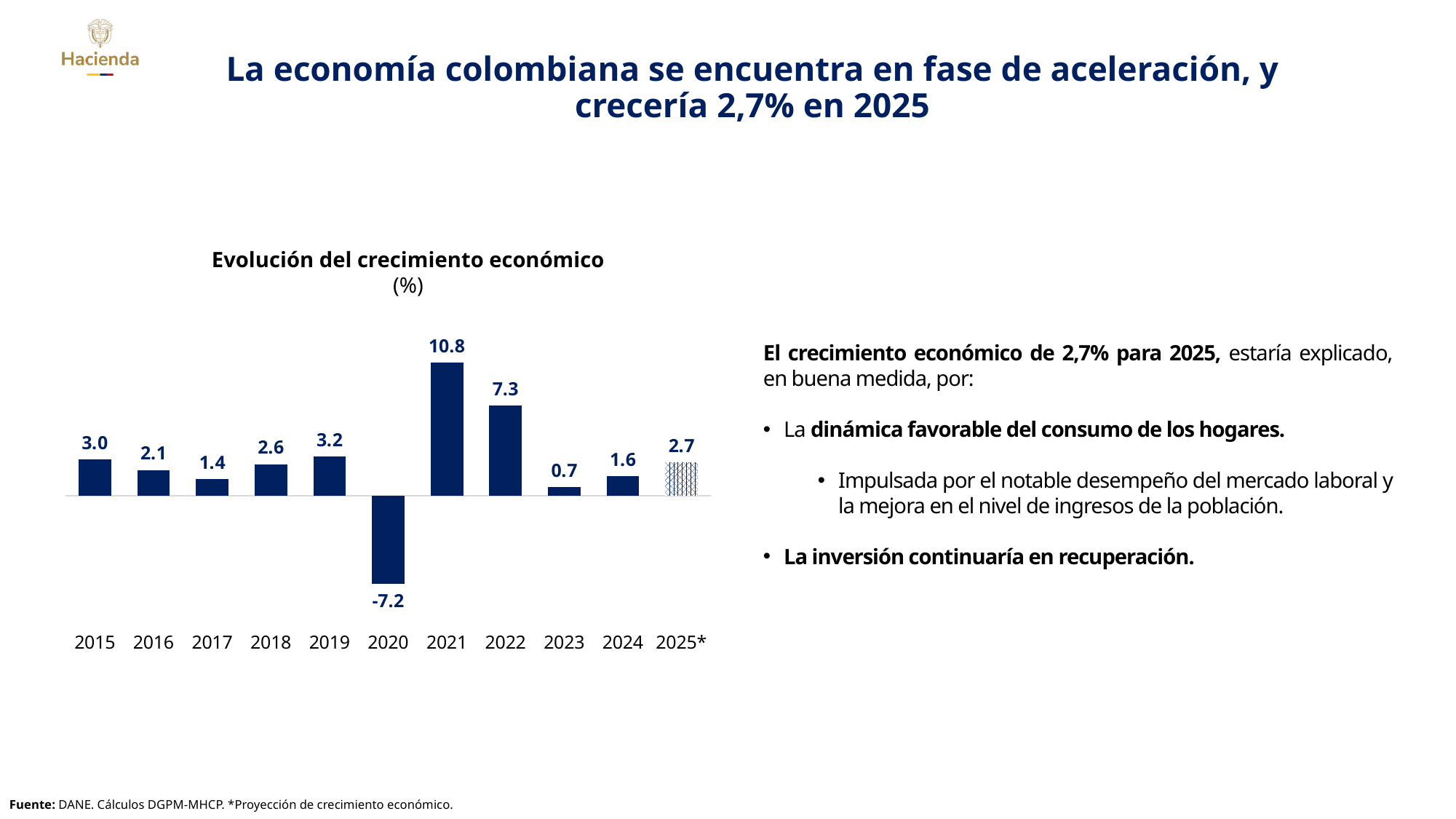
What is the projected economic growth value shown for 2025*? 2.7 What kind of chart is used to show the evolution of economic growth? Bar chart Which year has the lowest economic growth value in the chart? 2020 What is the difference between the growth values for 2021 and 2022? 3.5 Which year has a larger growth value, 2019 or 2018? 2019 How many years are shown on the x axis of the chart? 11 What is the economic growth value shown for 2021? 10.8 Do the growth values rise or fall from 2021 to 2023? Fall What is the economic growth value shown for 2020? -7.2 What is the difference between the growth values for 2024 and 2023? 0.9 Which year has the highest economic growth value in the chart? 2021 What is the title of the chart on the slide? Evolución del crecimiento económico (%)